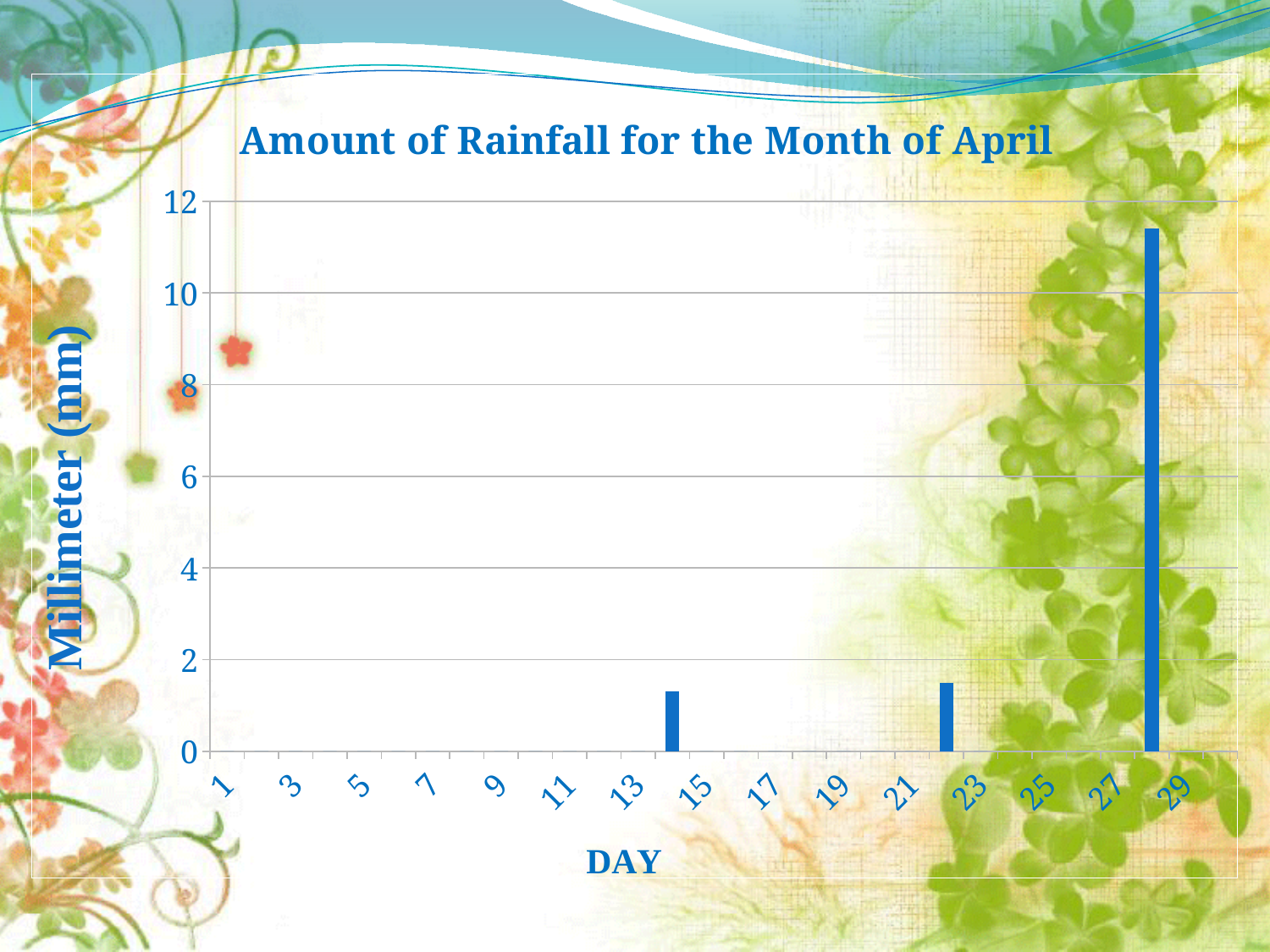
Is the tallest bar in the chart located near the beginning or near the end of the month? near the end Which is larger: the bar between day 27 and day 29 or the bar between day 21 and day 23? the bar between day 27 and day 29 What kind of chart is shown on the slide? bar chart Is the value of the tallest bar in the chart greater or less than 10? greater What is the label on the vertical axis of the chart? Millimeter (mm) How many day labels are printed along the horizontal axis of the chart? 15 How many days in the chart show a non-zero rainfall bar? 3 Is the value of the bar between day 21 and day 23 greater or less than 4? less Is the value of the tallest bar in the chart greater or less than 12? less What is the title of the chart? Amount of Rainfall for the Month of April